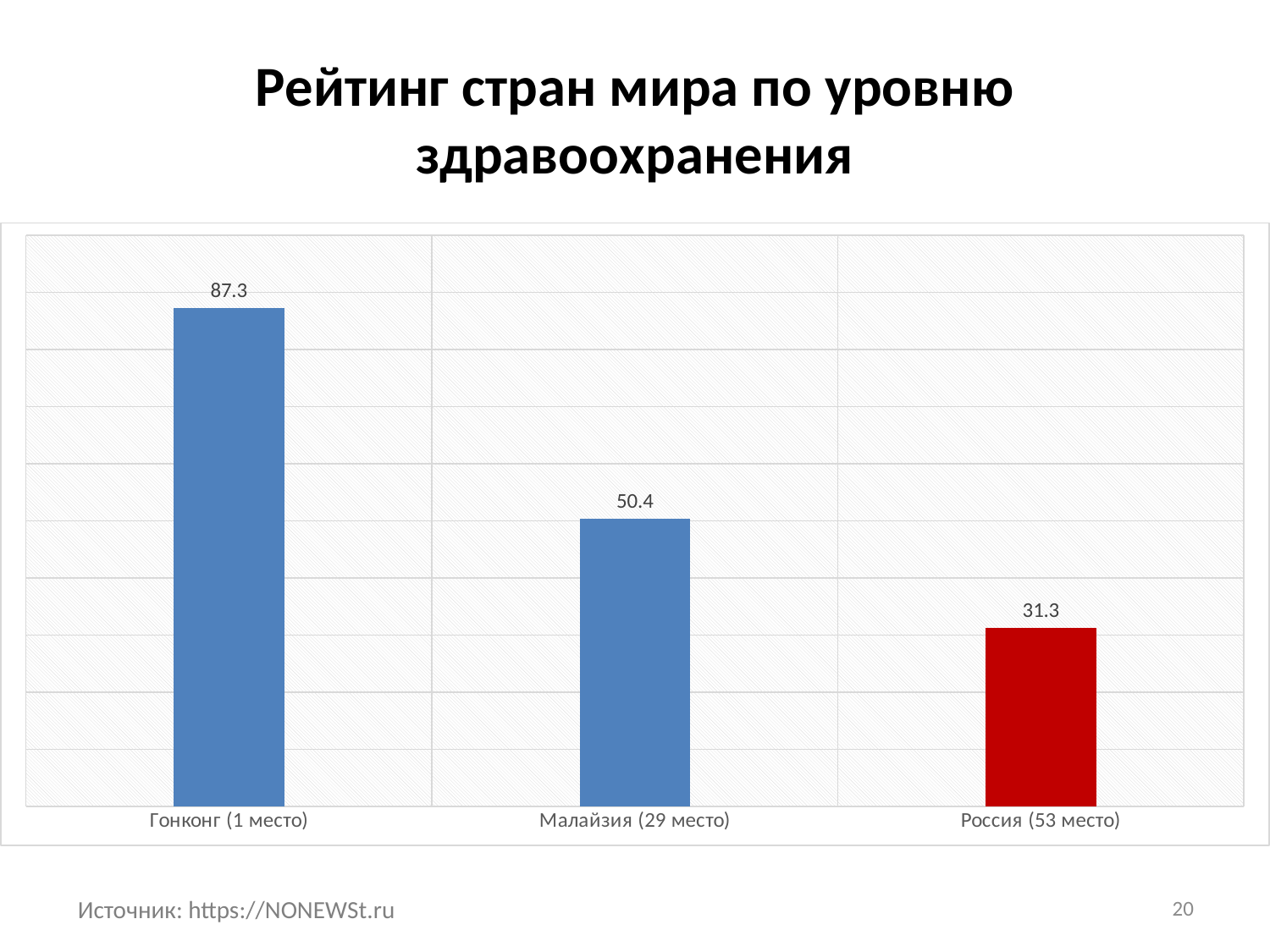
What is the difference between the values for Гонконг (1 место) and Россия (53 место)? 56.0 How many categories are shown in the chart? 3 What is the value for Россия (53 место)? 31.3 Which category has the lowest value? Россия (53 место) What is the value for Гонконг (1 место)? 87.3 What kind of chart is shown on the slide? Bar chart Do the values rise or fall from left to right along the x axis? Fall Which is larger, the value for Малайзия (29 место) or the value for Россия (53 место)? Малайзия (29 место) What is the value for Малайзия (29 место)? 50.4 What is the difference between the values for Малайзия (29 место) and Россия (53 место)? 19.1 Which category has the highest value? Гонконг (1 место) Which bar is coloured red? Россия (53 место)